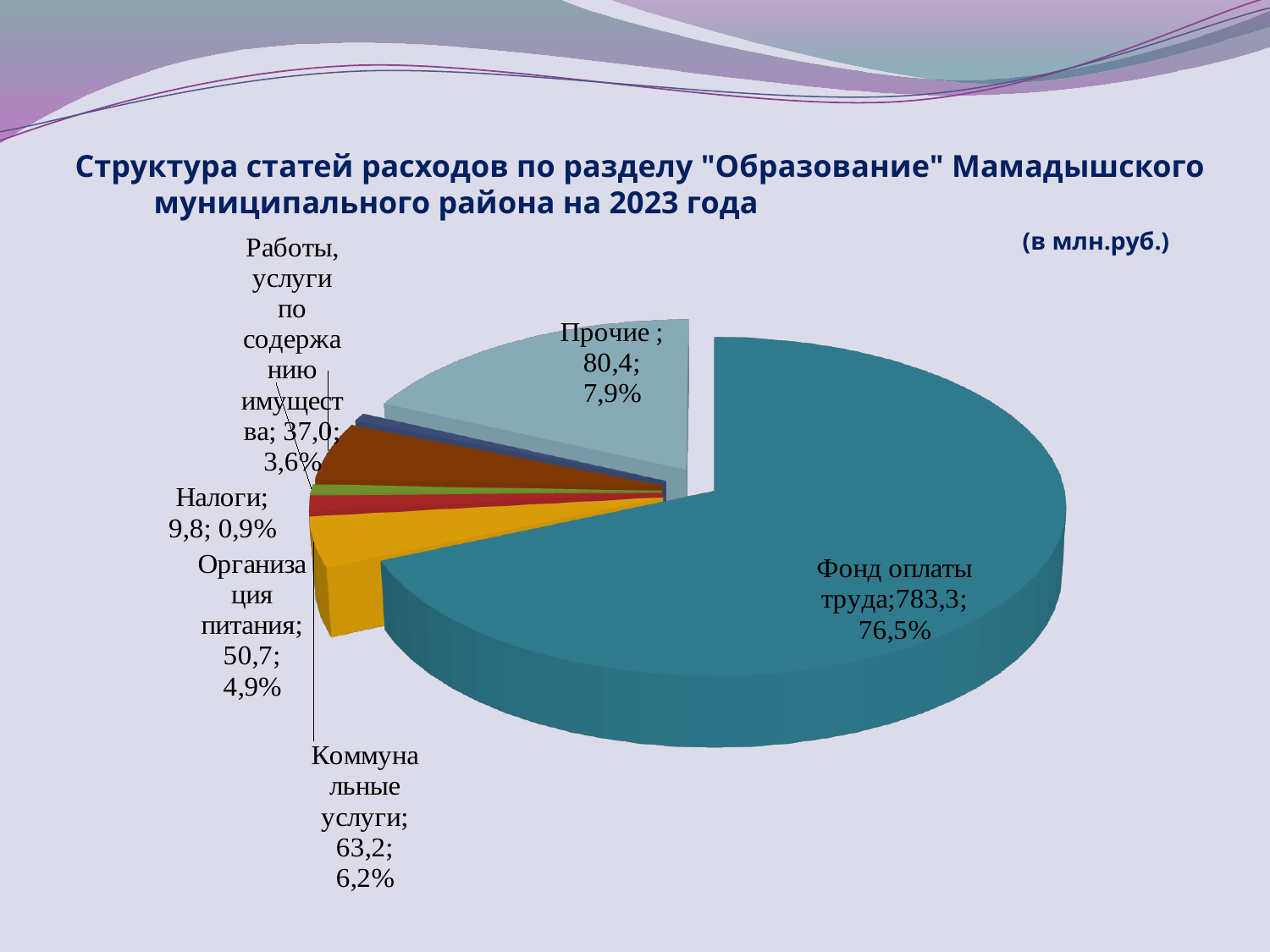
Which category has the largest slice? Фонд оплаты труда What kind of chart is shown on the slide? Pie chart Which is larger, Прочие or Коммунальные услуги? Прочие What is the value for Прочие? 80,4 What is the value for Фонд оплаты труда? 783,3 What is the value for Организация питания? 50,7 What share of the pie does Работы, услуги по содержанию имущества take? 3,6% What share of the pie does Коммунальные услуги take? 6,2% What is the value for Налоги? 9,8 What share of the pie does Фонд оплаты труда take? 76,5% Which labelled category has the smallest value? Налоги What is the difference between the values for Прочие and Коммунальные услуги? 17,2